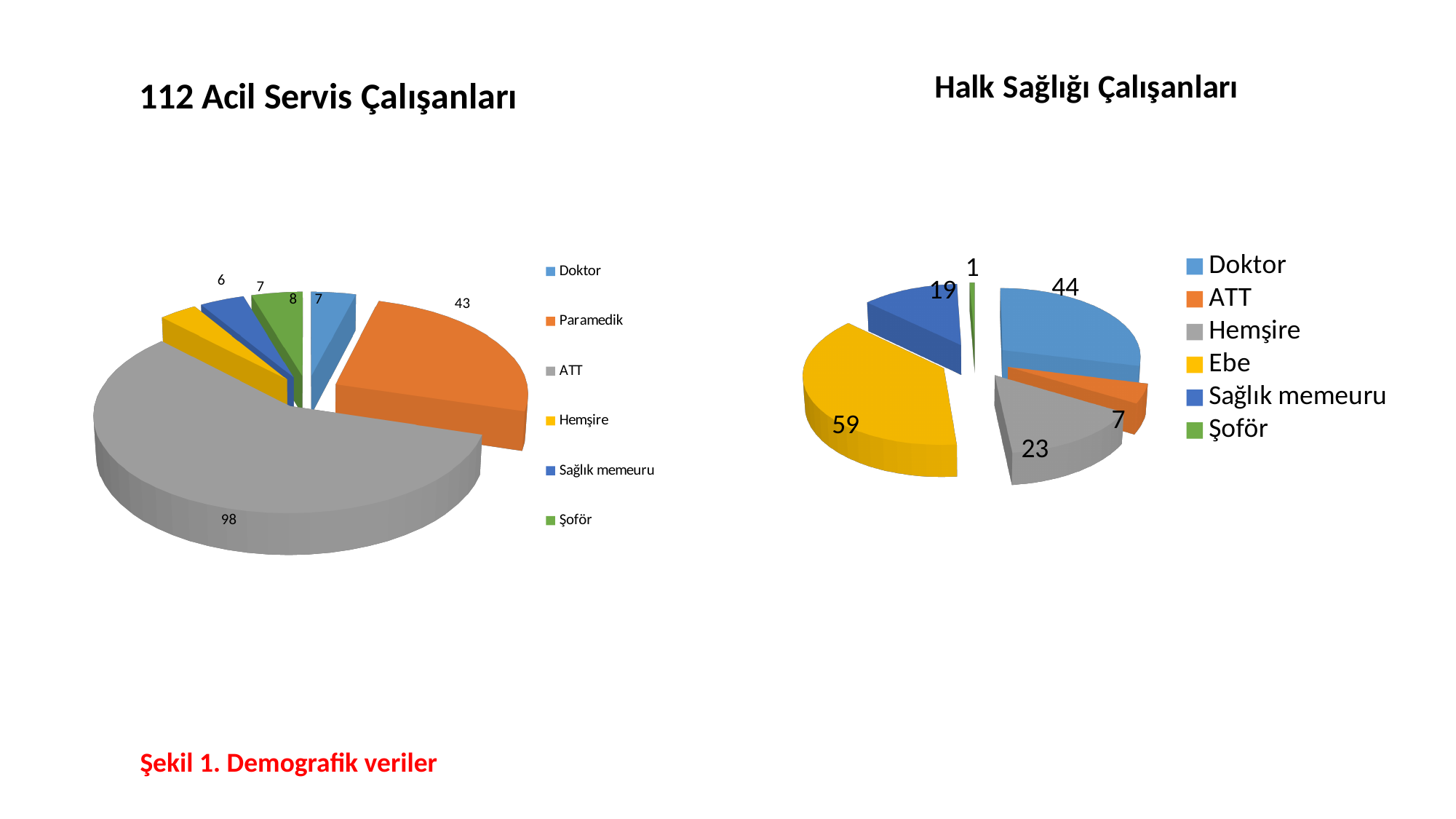
In the 'Halk Sağlığı Çalışanları' chart, which is larger, Doktor or Sağlık memeuru? Doktor In the 'Halk Sağlığı Çalışanları' chart, which category has the smallest value? Şoför In the '112 Acil Servis Çalışanları' chart, how many categories does the legend list? 6 In the '112 Acil Servis Çalışanları' chart, what is the value for Paramedik? 43 What colour is the Ebe slice in the 'Halk Sağlığı Çalışanları' chart? Yellow In the 'Halk Sağlığı Çalışanları' chart, what is the value for Hemşire? 23 What kind of chart is the 'Halk Sağlığı Çalışanları' chart? Pie chart In the 'Halk Sağlığı Çalışanları' chart, what is the difference between the Ebe and Doktor values? 15 In the '112 Acil Servis Çalışanları' chart, what is the difference between the ATT and Paramedik values? 55 In the 'Halk Sağlığı Çalışanları' chart, what is the value for Ebe? 59 In the '112 Acil Servis Çalışanları' chart, which category has the largest slice? ATT In the '112 Acil Servis Çalışanları' chart, what is the value for ATT? 98